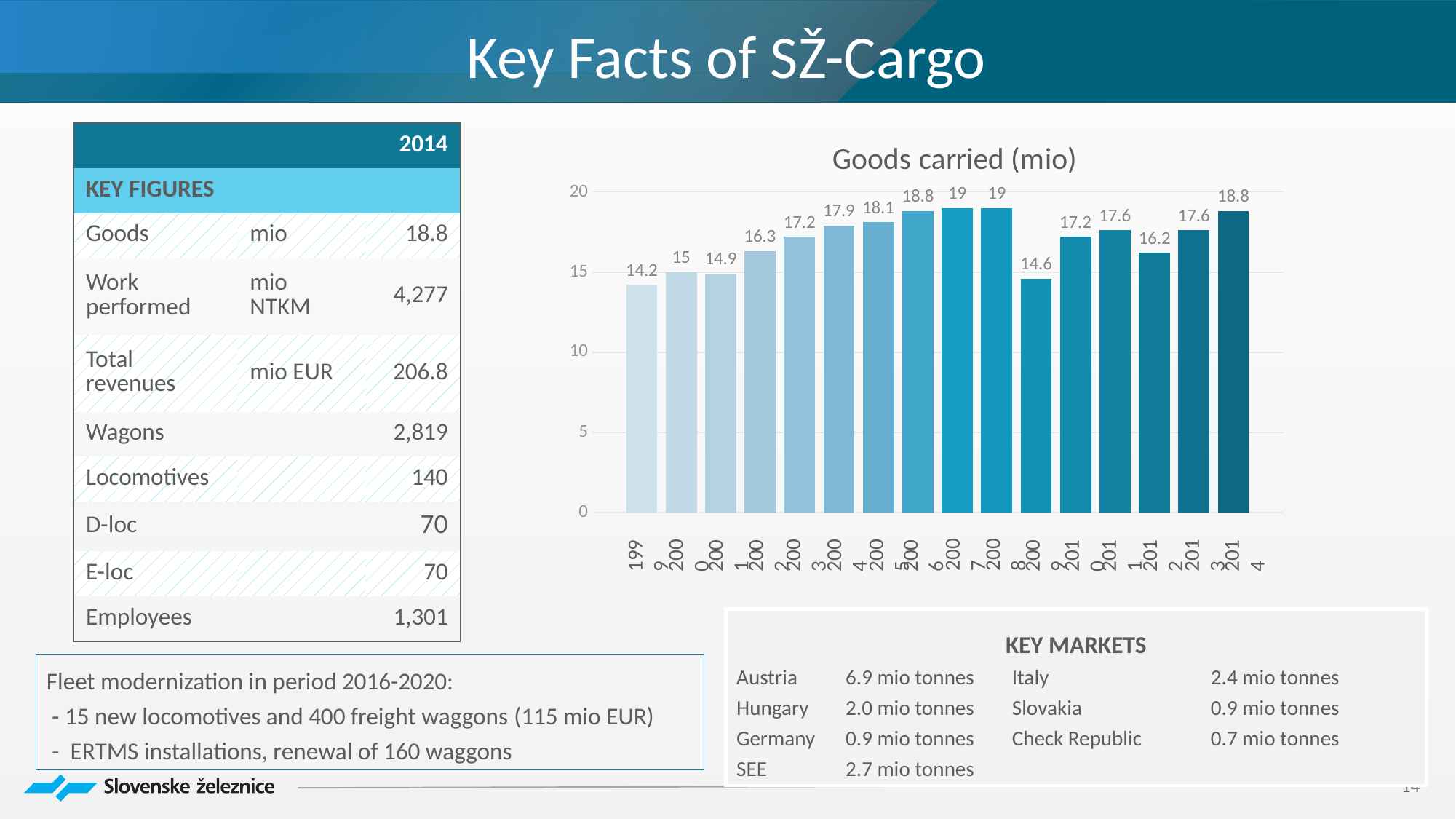
What is the value of goods carried for 2014, the last bar? 18.8 What type of chart is shown on the slide? bar chart What is the difference between goods carried in 2007 and in 2008? 0 How many bars are plotted in the Goods carried chart? 16 What is the value of goods carried for 2008? 19 Which is larger, goods carried in 2005 or in 2009? 2005 What is the value of goods carried for 1999, the first bar? 14.2 What is the value of goods carried for 2012? 16.2 What is the title of the chart? Goods carried (mio) Which year has the lowest value of goods carried? 1999 Do the values generally rise or fall from 1999 to 2007? rise What is the highest value shown in the Goods carried chart? 19